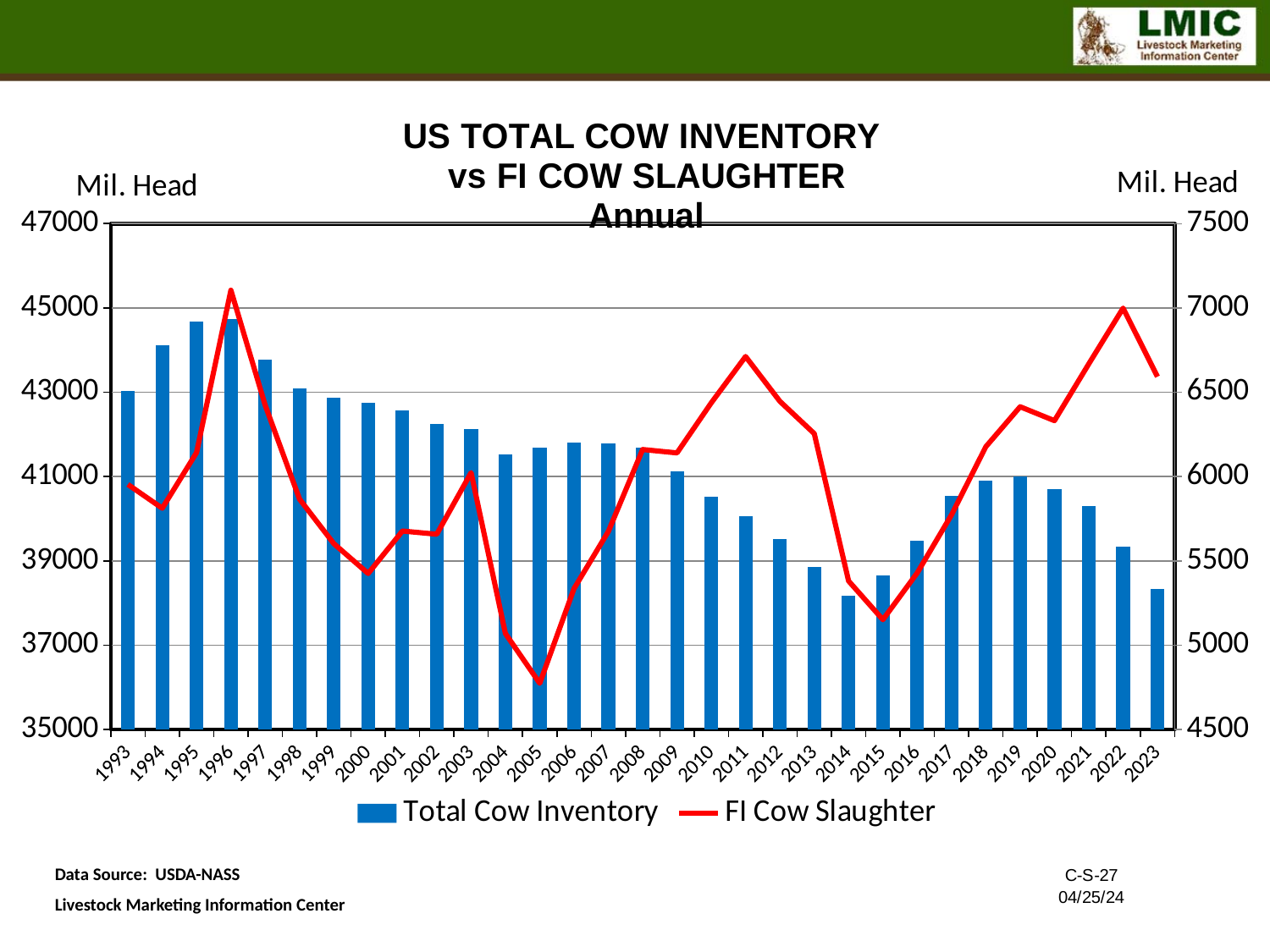
Is the Total Cow Inventory value for 2023 greater or less than 39000? less Is the Total Cow Inventory value for 1997 greater or less than 43000? greater Is the Total Cow Inventory value for 2010 greater or less than 41000? less What unit label is shown above the left and right axes? Mil. Head What kind of chart is shown on the slide? A combined bar and line chart How many years are plotted along the x axis? 31 How many series does the legend list? 2 Which year has the larger Total Cow Inventory, 1994 or 2020? 1994 Does Total Cow Inventory generally rise or fall from 1993 to 2023? fall In which year is the FI Cow Slaughter line at its lowest? 2005